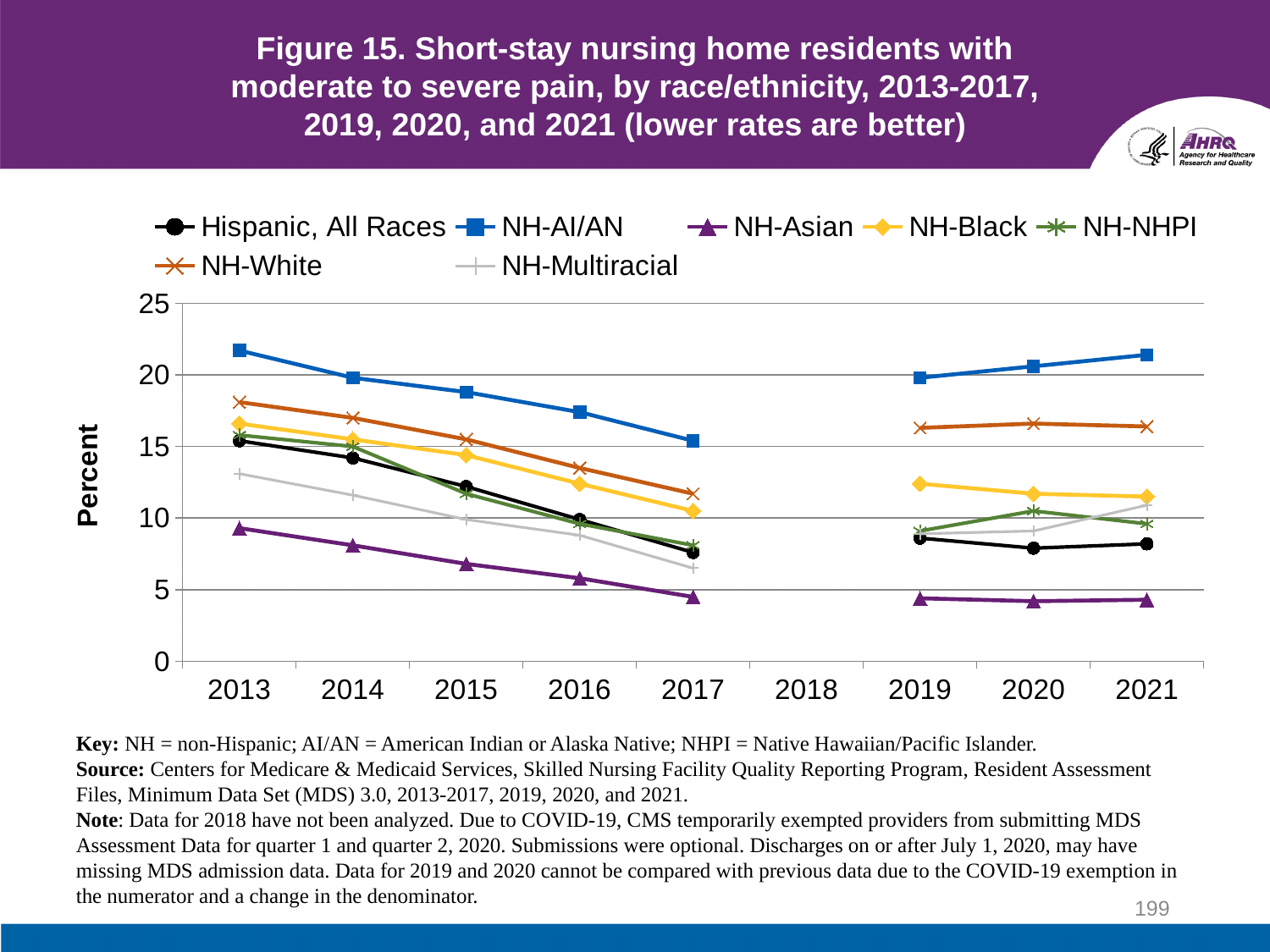
What kind of chart is shown on the slide? line chart Is the value for NH-Asian in 2017 greater or less than 5? less Is the value for NH-White in 2017 greater or less than 10? greater How many year labels appear on the x axis? 9 What is the label on the y axis? Percent How many series does the legend list? 7 Which race/ethnicity group has the highest value in 2013? NH-AI/AN In 2019, which is larger: the value for NH-White or the value for NH-Black? NH-White Which race/ethnicity group has the lowest value in 2021? NH-Asian Do the values for NH-Asian rise or fall from 2013 to 2017? fall Do the values for NH-AI/AN rise or fall from 2019 to 2021? rise Is the value for NH-AI/AN in 2013 greater or less than 20? greater